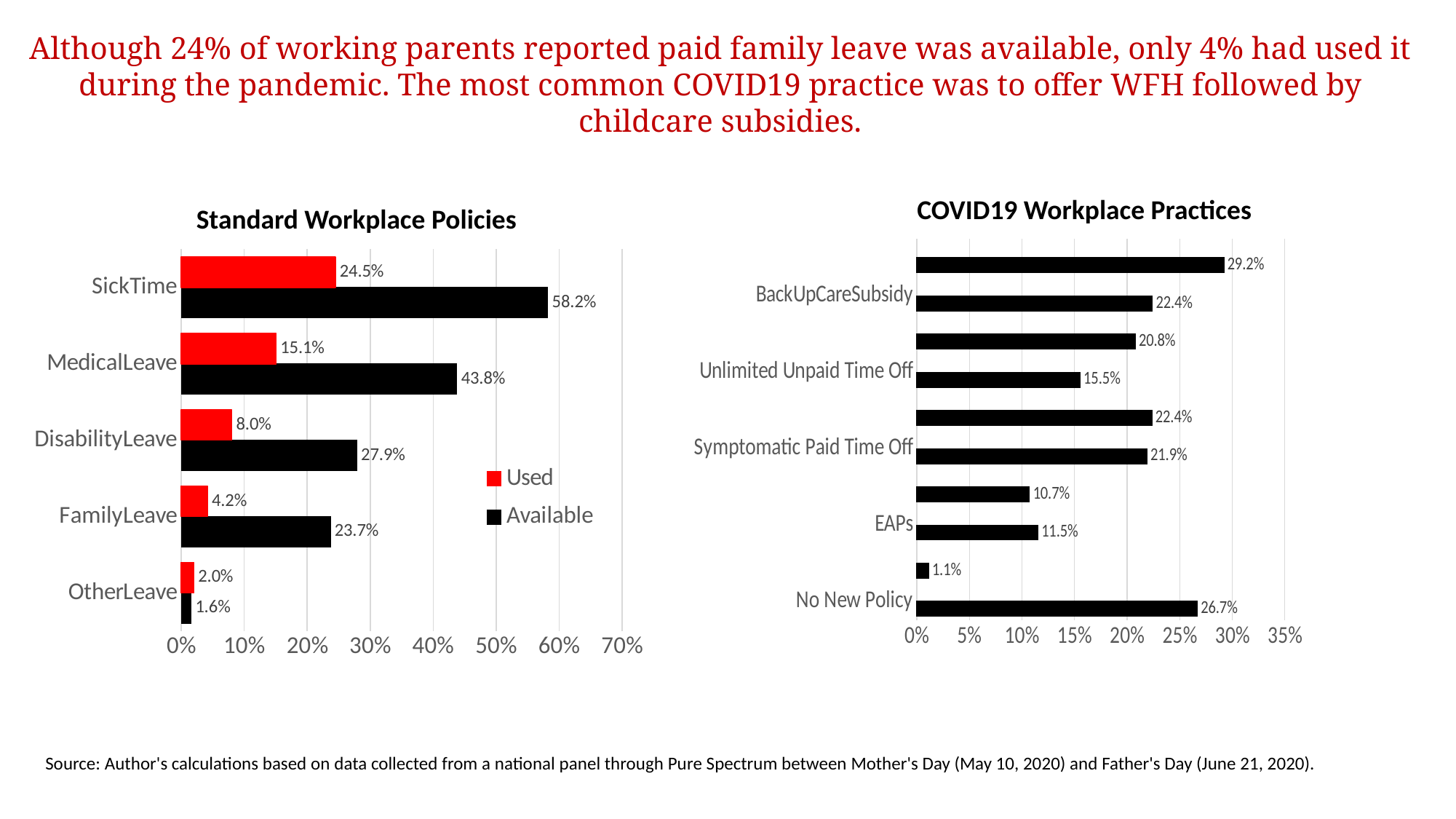
In the Standard Workplace Policies chart, what is the difference between the Available and Used values for DisabilityLeave? 19.9% In the Standard Workplace Policies chart, what colour are the Used bars? Red How many policies are listed on the y axis of the Standard Workplace Policies chart? 5 In the Standard Workplace Policies chart, which policy has the highest Available value? SickTime What kind of chart is the COVID19 Workplace Practices chart? Bar chart How many series does the legend of the Standard Workplace Policies chart list? 2 In the Standard Workplace Policies chart, what is the Available value for SickTime? 58.2% In the Standard Workplace Policies chart, what is the Available value for MedicalLeave? 43.8% In the COVID19 Workplace Practices chart, what is the highest value shown on any bar? 29.2% In the Standard Workplace Policies chart, what is the Used value for FamilyLeave? 4.2% In the Standard Workplace Policies chart, which is larger for OtherLeave: the Used value or the Available value? Used In the Standard Workplace Policies chart, which policy has the lowest Used value? OtherLeave